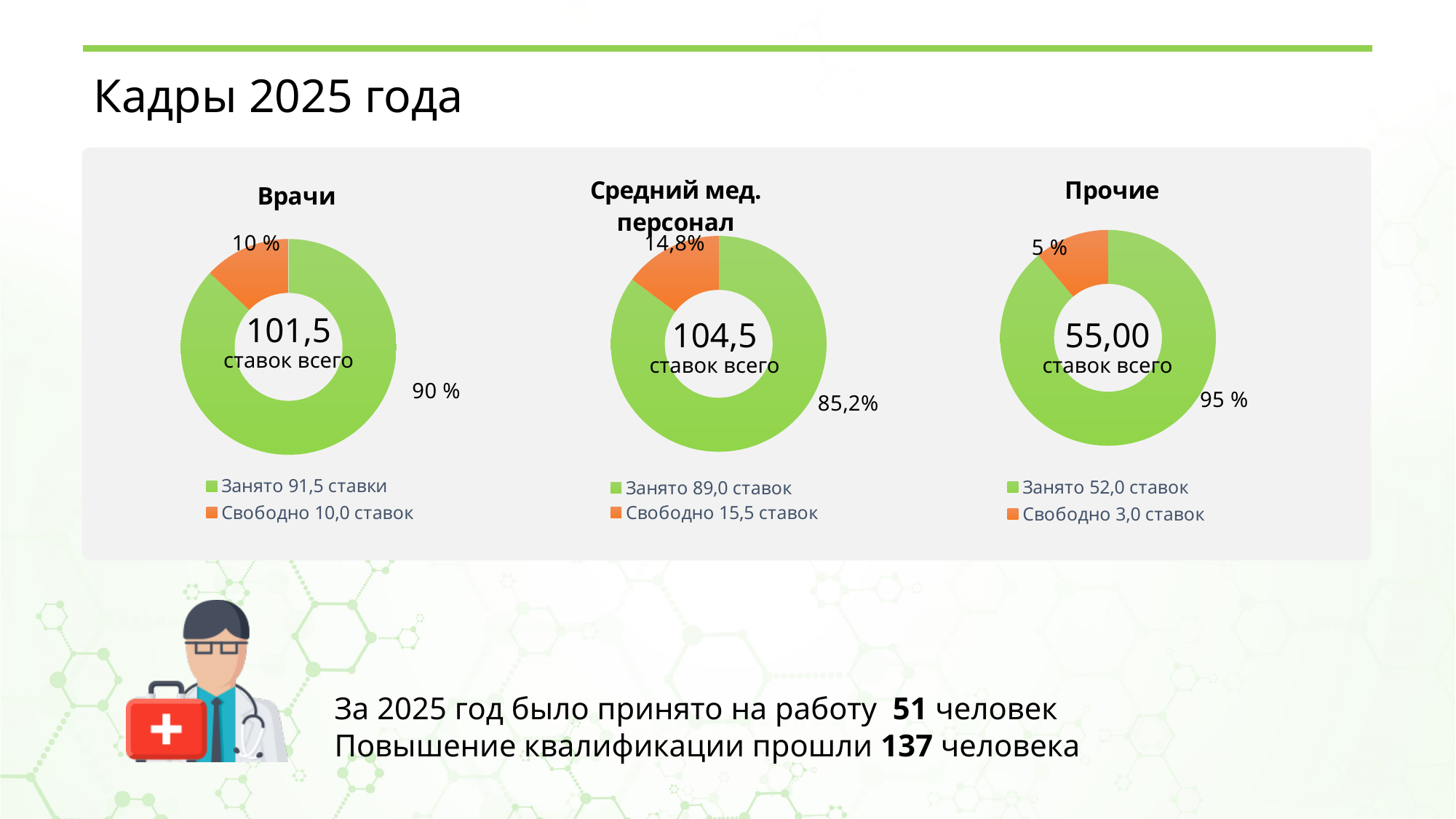
In the "Врачи" chart, what share is shown for "Свободно"? 10 % In the "Средний мед. персонал" chart, what share is shown for "Занято"? 85,2% What total number of positions is shown in the centre of the "Прочие" chart? 55,00 According to the legend of the "Средний мед. персонал" chart, how many positions are free (Свободно)? 15,5 ставок Which of the three charts has the smallest free (Свободно) share? Прочие In the "Врачи" chart, what share of positions is shown as occupied (Занято)? 90 % According to the legend of the "Врачи" chart, how many positions are occupied (Занято)? 91,5 ставки Which of the three charts has the largest free (Свободно) share? Средний мед. персонал How many series does the legend of the "Прочие" chart list? 2 What kind of chart is used for "Врачи"? Donut (pie) chart